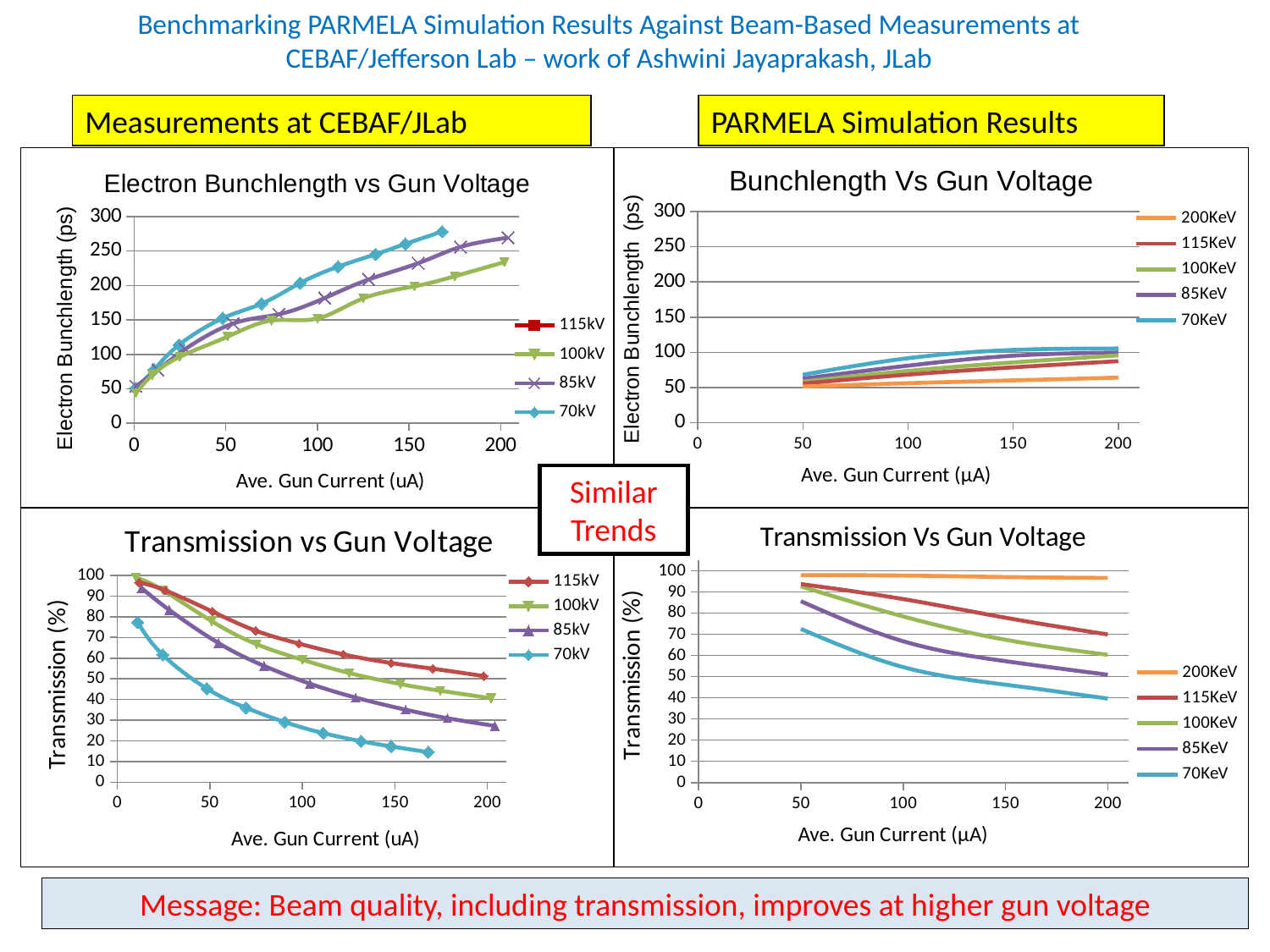
In the "Transmission Vs Gun Voltage" chart at the bottom right, is the value of the 70KeV series at 200 µA greater or less than 50? less How many series does the legend of the "Transmission vs Gun Voltage" chart at the bottom left list? 4 What is the x-axis label of the "Transmission Vs Gun Voltage" chart at the bottom right? Ave. Gun Current (µA) In the "Transmission Vs Gun Voltage" chart at the bottom right, do the values rise or fall as gun current increases? fall In the "Transmission Vs Gun Voltage" chart at the bottom right, which series has the highest transmission across the plotted range? 200KeV What kind of chart is the "Electron Bunchlength vs Gun Voltage" chart at the top left? line chart In the "Electron Bunchlength vs Gun Voltage" chart at the top left, is the last plotted value of the 70kV series greater or less than 250? greater How many series does the legend of the "Bunchlength Vs Gun Voltage" chart at the top right list? 5 In the "Bunchlength Vs Gun Voltage" chart at the top right, is the value of the 70KeV series at 200 µA greater or less than 150? less In the "Transmission Vs Gun Voltage" chart at the bottom right, which series has the lowest transmission across the plotted range? 70KeV In the "Transmission vs Gun Voltage" chart at the bottom left, at 200 uA, which series has the higher transmission: 115kV or 100kV? 115kV In the "Electron Bunchlength vs Gun Voltage" chart at the top left, do the values rise or fall as gun current increases? rise